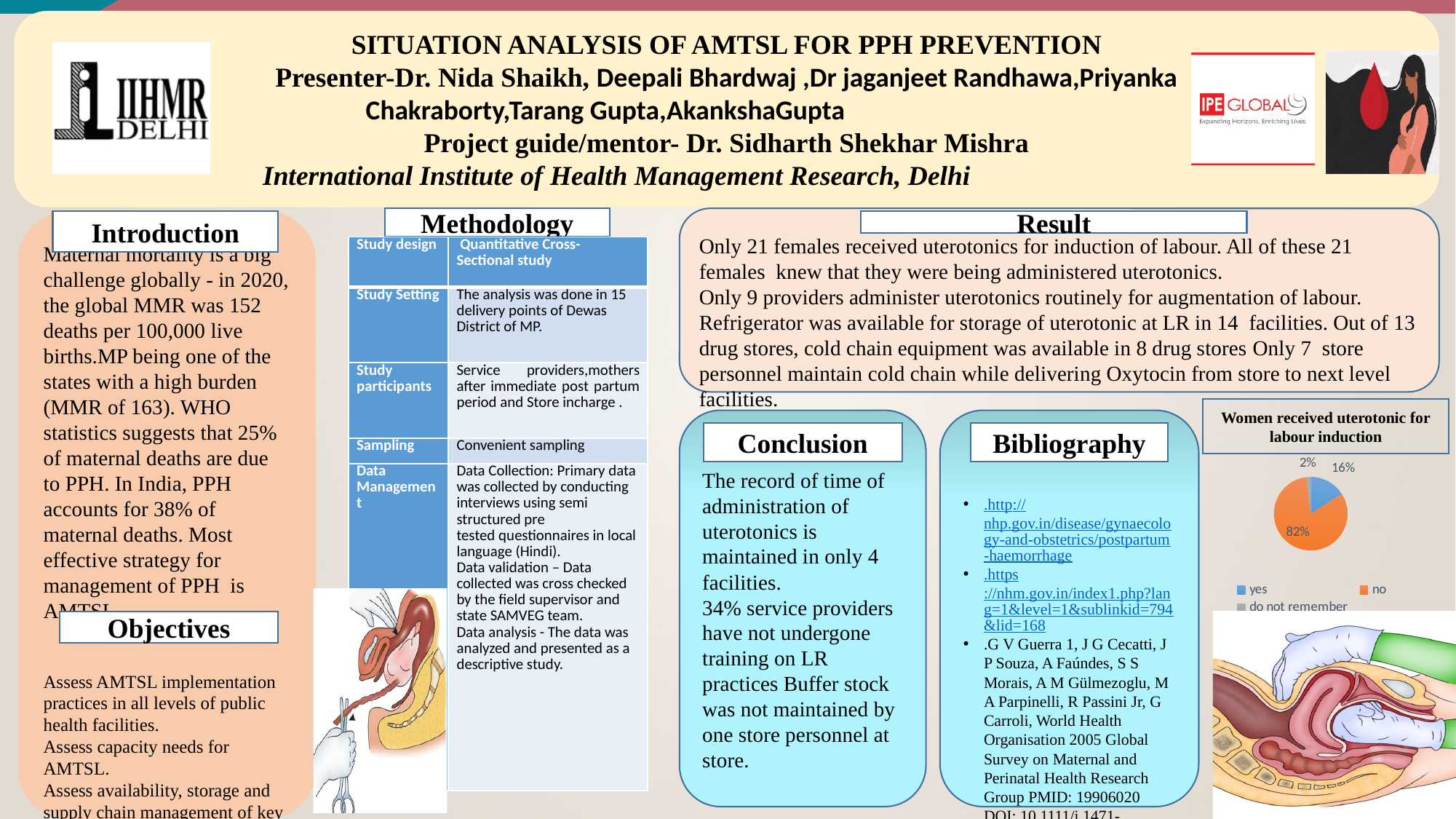
In the pie chart, what percentage of women answered "yes"? 16% Which category has the largest slice in the pie chart? no Which category has the smallest slice in the pie chart? do not remember In the pie chart, what is the combined share of "yes" and "do not remember"? 18% What kind of chart is shown under the title "Women received uterotonic for labour induction"? pie chart How many categories does the legend of the pie chart list? 3 In the pie chart, what is the difference between the "no" share and the "yes" share? 66% In the pie chart, which is larger: the "yes" slice or the "do not remember" slice? yes What is the title of the pie chart? Women received uterotonic for labour induction What colour is the "no" slice in the pie chart? orange In the pie chart, what percentage of women answered "no"? 82% In the pie chart, what percentage of women answered "do not remember"? 2%